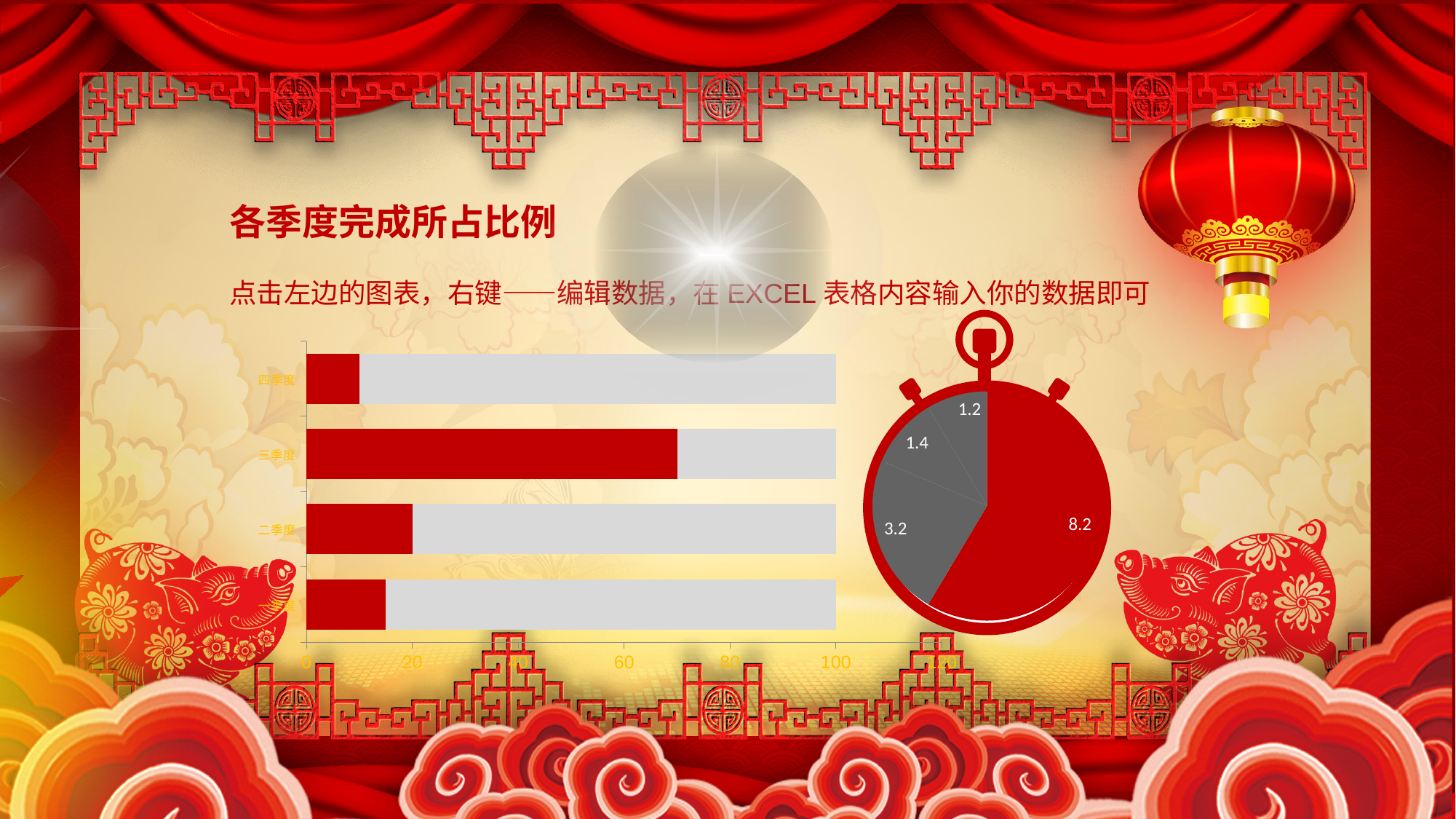
In the bar chart on the left, which is larger, the value for 三季度 or the value for 二季度? 三季度 In the pie chart on the right, what is the value of the smallest slice? 1.2 In the bar chart on the left, which quarter has the lowest value? 四季度 What is the title of the chart section on the slide? 各季度完成所占比例 In the pie chart on the right, what is the value of the largest slice? 8.2 How many quarters (categories) are shown in the bar chart on the left? 4 What kind of chart is the chart on the right of the slide (inside the stopwatch)? pie chart What kind of chart is the chart on the left of the slide? bar chart In the pie chart on the right, what is the difference between the 8.2 slice and the 3.2 slice? 5.0 In the bar chart on the left, is the value for 三季度 greater or less than 60? greater In the bar chart on the left, is the value for 四季度 greater or less than 20? less In the bar chart on the left, which quarter has the highest value? 三季度